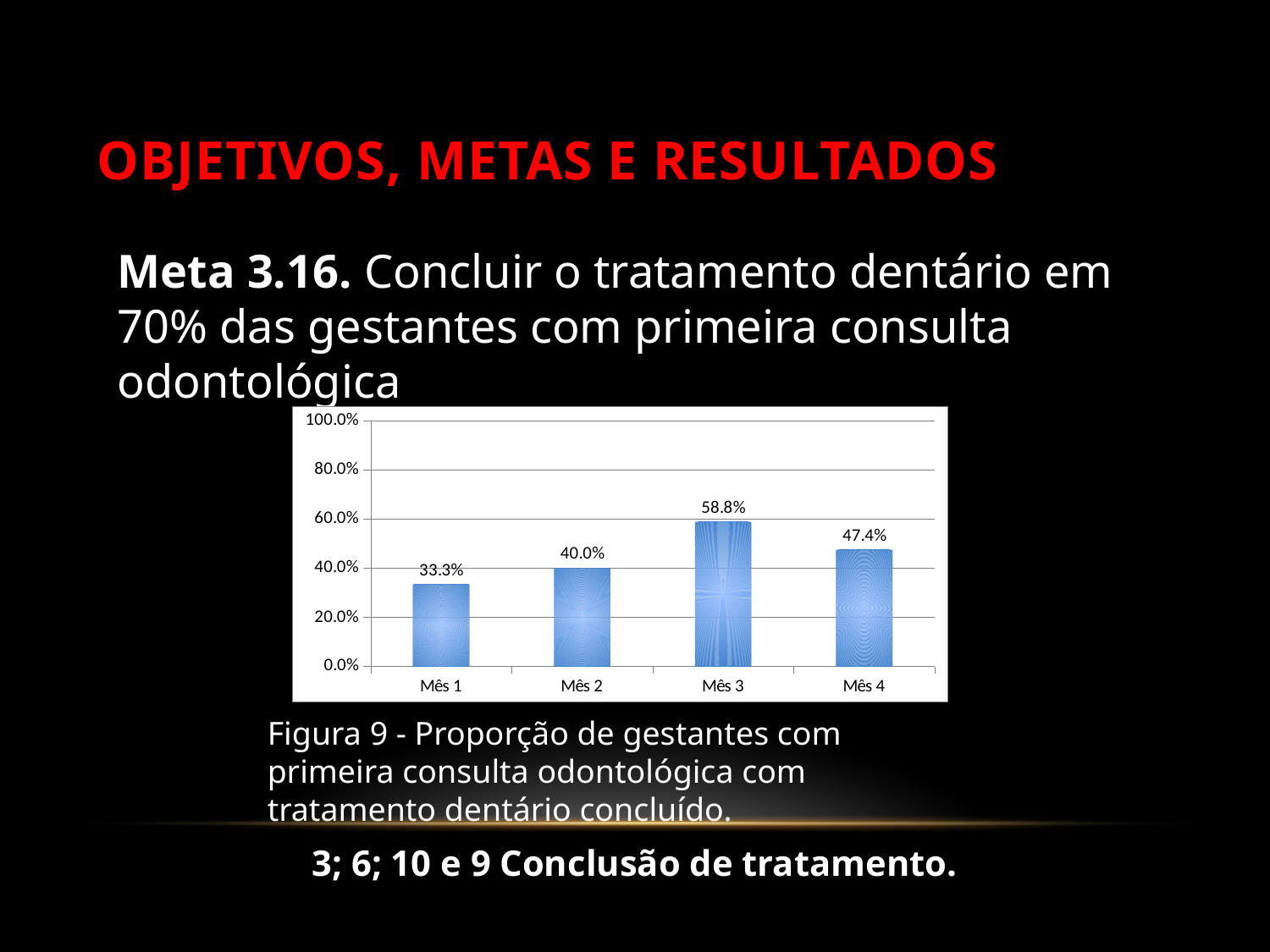
Is the value for Mês 3 greater or less than 60.0%? less Which is larger, the value for Mês 2 or the value for Mês 4? Mês 4 Which month has the highest value? Mês 3 What is the value for Mês 2? 40.0% What is the difference between the values for Mês 3 and Mês 1? 25.5% What is the highest value shown on the y axis? 100.0% Which month has the lowest value? Mês 1 What is the value for Mês 1? 33.3% What is the value for Mês 4? 47.4% How many months are shown on the x axis? 4 What is the value for Mês 3? 58.8% What kind of chart is shown on the slide? bar chart